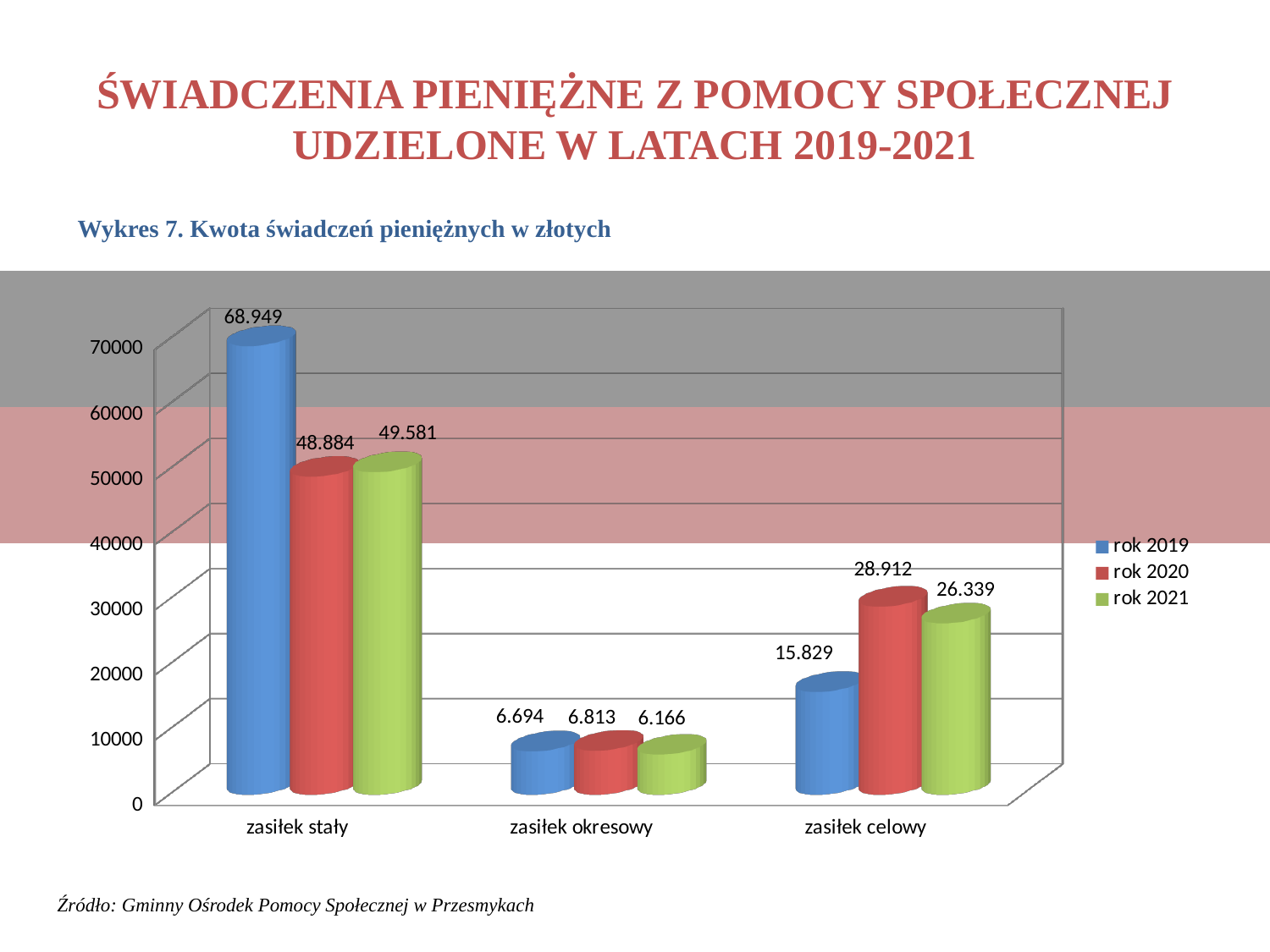
Is the value for zasiłek stały in rok 2021 greater or less than 40000? greater Which category has the highest value in rok 2021? zasiłek stały How many series does the legend list? 3 Which is larger for zasiłek celowy: the rok 2020 value or the rok 2021 value? rok 2020 What is the difference between the rok 2019 and rok 2020 values for zasiłek stały? 20.065 What is the difference between the rok 2020 and rok 2019 values for zasiłek celowy? 13.083 What is the value for zasiłek stały in rok 2019? 68.949 What is the value for zasiłek okresowy in rok 2021? 6.166 What is the value for zasiłek celowy in rok 2020? 28.912 What kind of chart is shown on the slide? bar chart Which category has the lowest value in rok 2019? zasiłek okresowy How many categories are shown on the x axis? 3